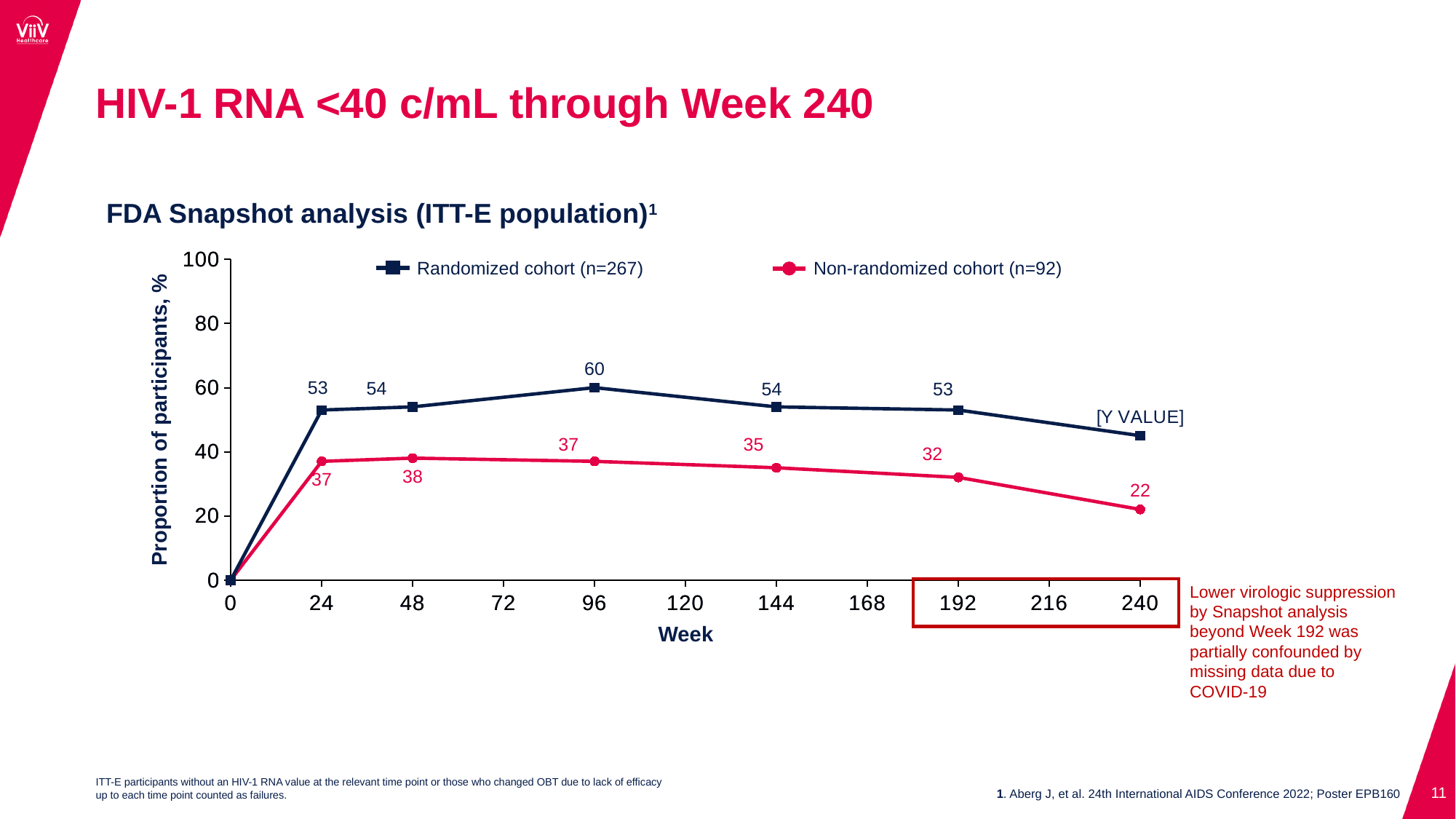
Is the value for the Randomized cohort at Week 240 greater or less than 40? greater What is the value for the Randomized cohort at Week 96? 60 What is the value for the Non-randomized cohort at Week 240? 22 What is the value for the Non-randomized cohort at Week 48? 38 At which week is the Non-randomized cohort lowest, excluding Week 0? Week 240 Which cohort has the higher value at Week 24? Randomized cohort (n=267) What kind of chart is shown on the slide? Line chart Does the Non-randomized cohort rise or fall from Week 96 to Week 240? Fall What is the value for the Randomized cohort at Week 192? 53 What is the difference between the Randomized and Non-randomized cohorts at Week 144? 19 How many series does the legend list? 2 At which week does the Randomized cohort reach its highest labelled value? Week 96